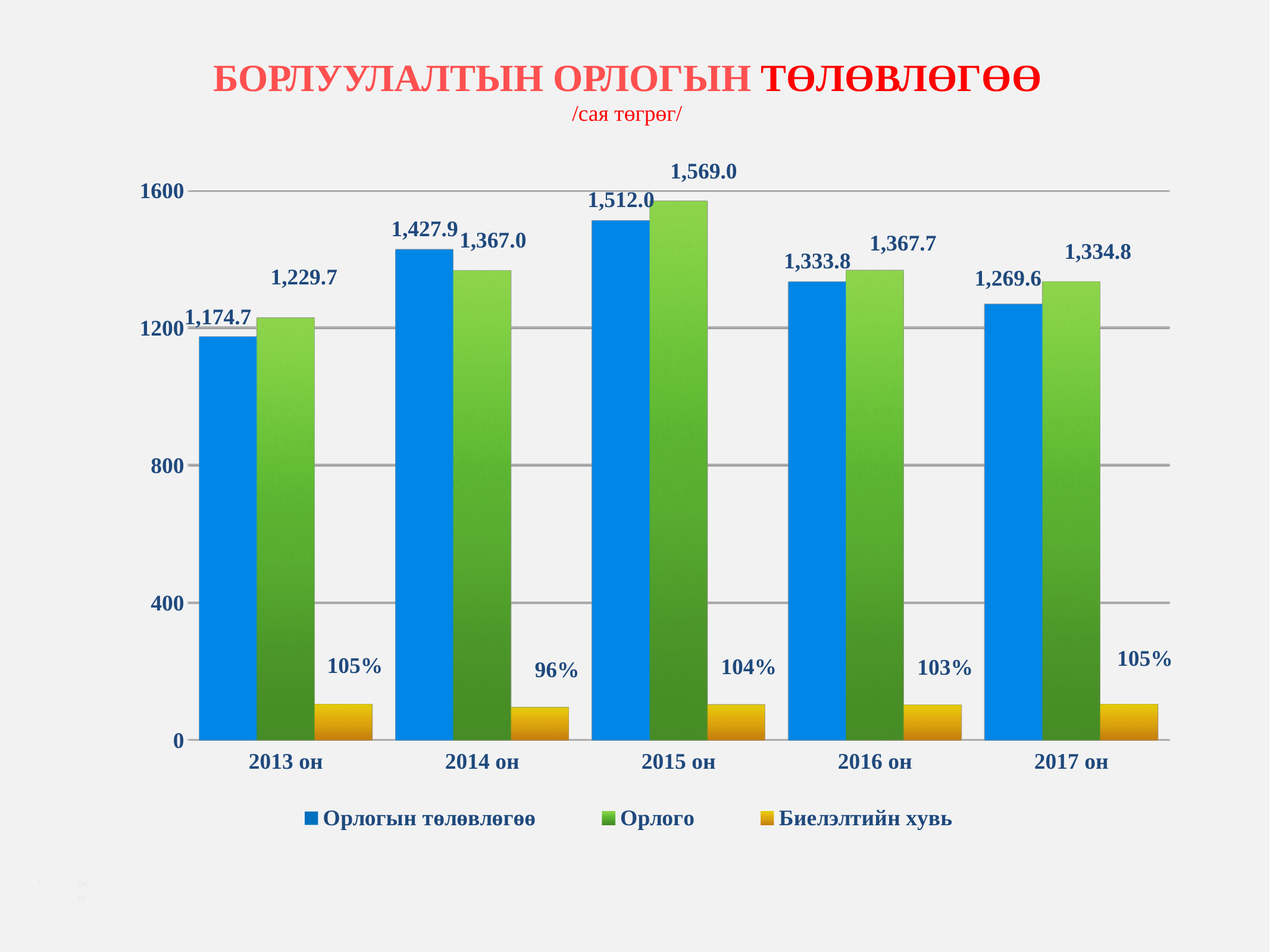
In which year is Биелэлтийн хувь lowest? 2014 он What is the difference between Орлого and Орлогын төлөвлөгөө for 2015 он? 57.0 Is the Орлогын төлөвлөгөө value for 2013 он greater or less than 1200? less What kind of chart is shown on the slide? bar chart What is the value of Орлогын төлөвлөгөө for 2015 он? 1,512.0 What is the value of Орлого for 2017 он? 1,334.8 How many years are shown on the x axis? 5 How many series does the legend list? 3 For 2014 он, which is larger: Орлогын төлөвлөгөө or Орлого? Орлогын төлөвлөгөө What is the Биелэлтийн хувь value for 2014 он? 96% In which year is Орлогын төлөвлөгөө lowest? 2013 он In which year is Орлого highest? 2015 он